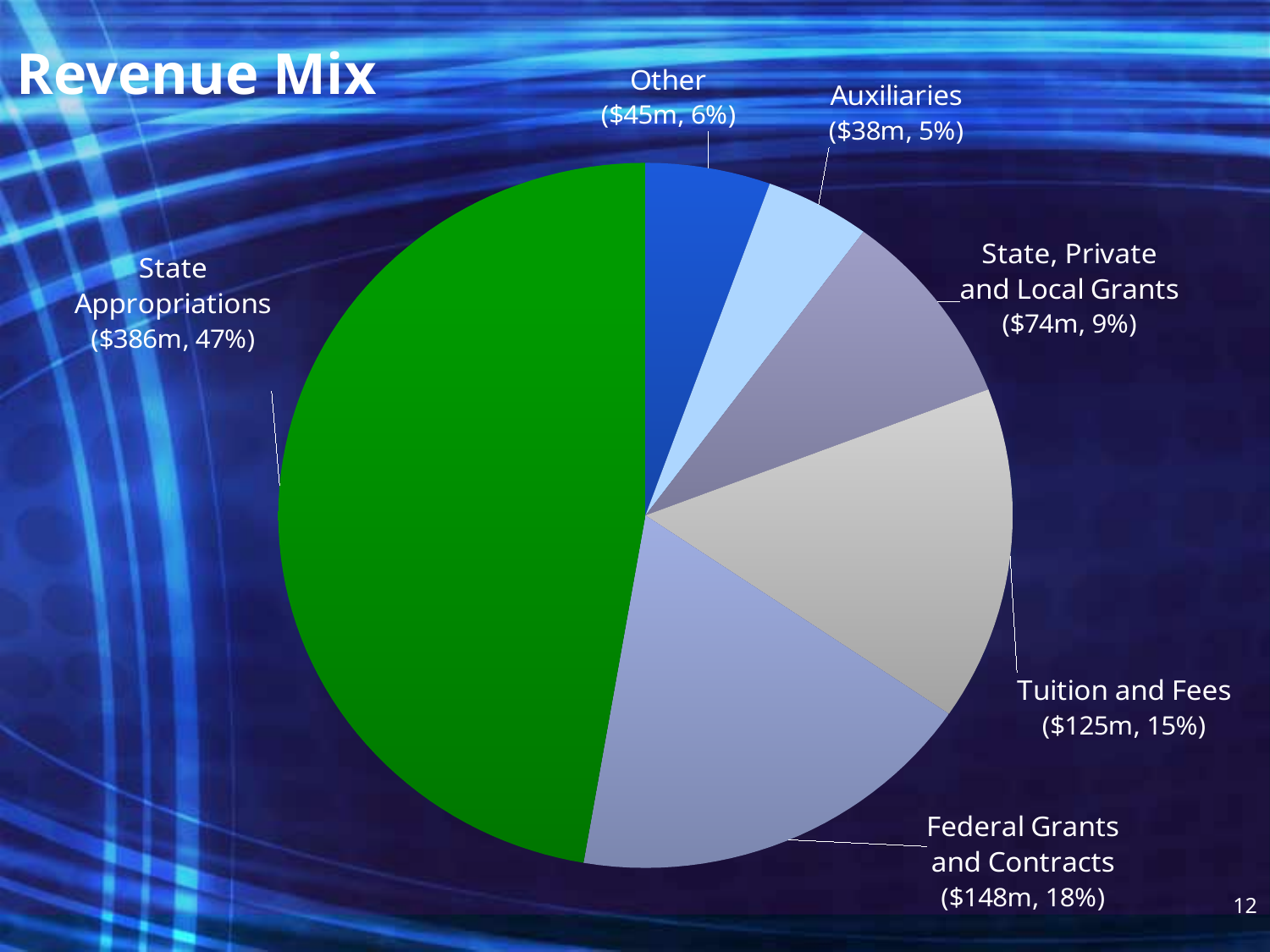
How many slices does the pie chart have? 6 Which is larger, Other or Auxiliaries? Other What type of chart is shown on the slide? pie chart What colour is the State Appropriations slice? green What is the value shown for Federal Grants and Contracts? $148m What percentage share does Tuition and Fees have? 15% What is the difference in value between Federal Grants and Contracts and Tuition and Fees? $23m What is the value shown for State Appropriations? $386m Which category has the smallest share of the pie? Auxiliaries What is the title of the chart? Revenue Mix What percentage share does State, Private and Local Grants have? 9% Which category has the largest share of the pie? State Appropriations